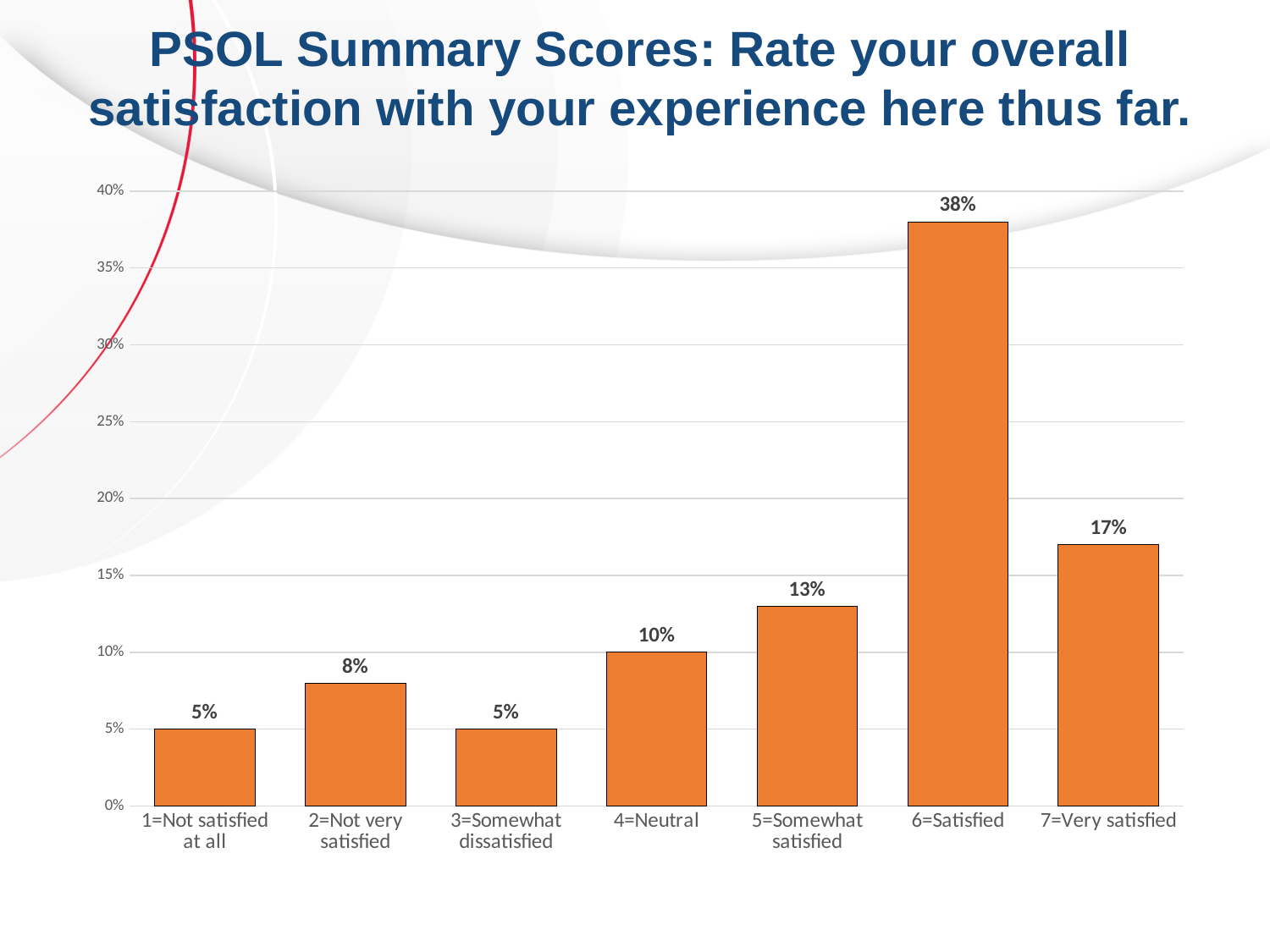
What is the combined value of 1=Not satisfied at all and 3=Somewhat dissatisfied? 10% What is the value for 4=Neutral? 10% What kind of chart is shown on the slide? Bar chart What colour are the bars in the chart? Orange Which category has the highest value? 6=Satisfied What percentage is shown for 7=Very satisfied? 17% What percentage of respondents chose 6=Satisfied? 38% Is the value for 6=Satisfied greater or less than 35%? greater What is the value for 2=Not very satisfied? 8% What is the difference between the values for 6=Satisfied and 7=Very satisfied? 21% Which is larger, the value for 2=Not very satisfied or the value for 5=Somewhat satisfied? 5=Somewhat satisfied How many categories are shown on the x axis? 7